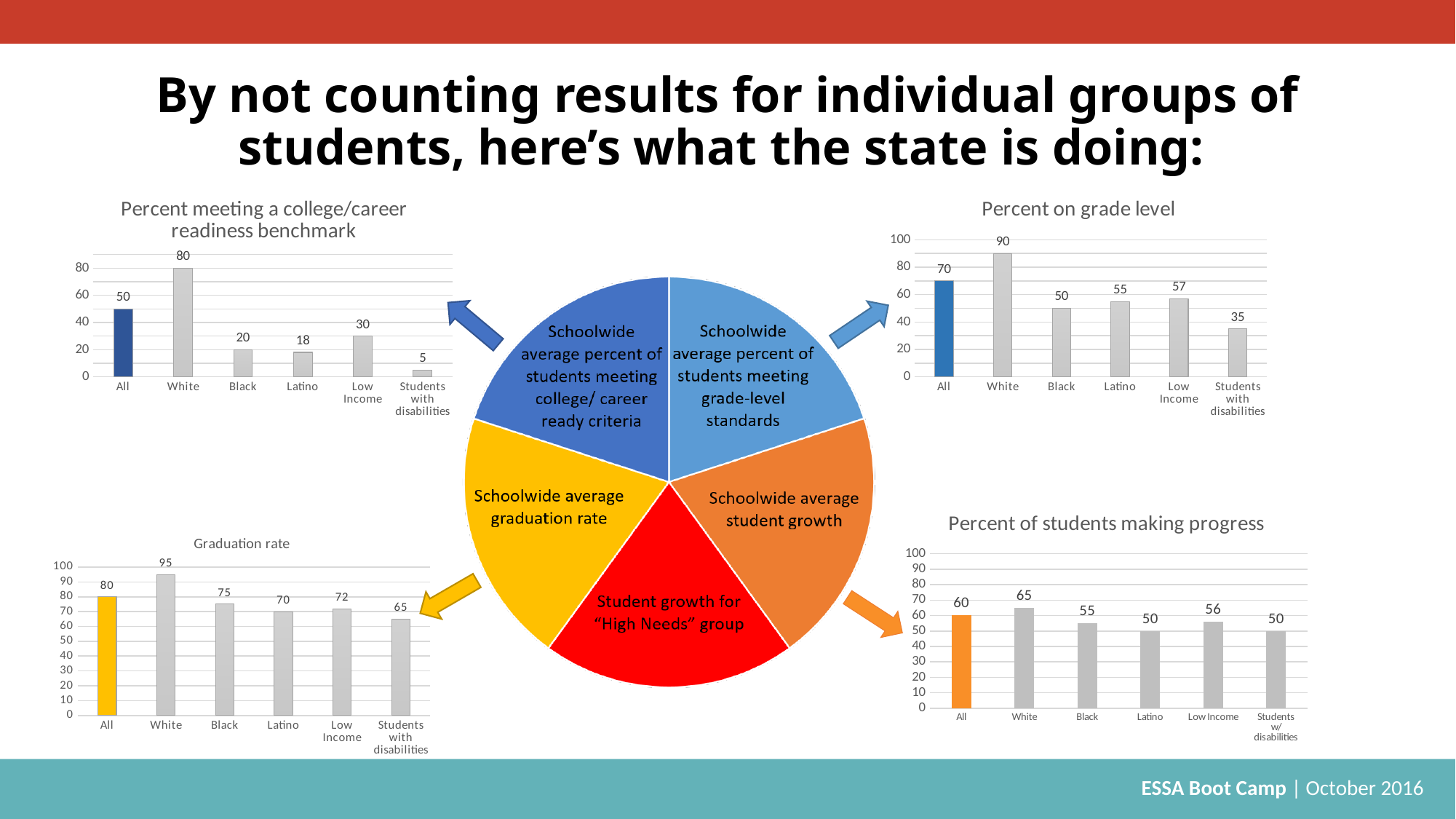
In the 'Percent meeting a college/career readiness benchmark' chart, which category has the lowest value? Students with disabilities In the 'Percent of students making progress' chart, what is the value for Black? 55 In the 'Graduation rate' chart, what is the difference between the All value and the White value? 15 What kind of chart is the 'Percent of students making progress' chart? Bar chart In the 'Percent on grade level' chart, what is the value for Low Income? 57 In the 'Percent meeting a college/career readiness benchmark' chart, what is the difference between the White value and the Latino value? 62 In the 'Graduation rate' chart, which is larger, the value for Latino or the value for Low Income? Low Income In the 'Graduation rate' chart, what is the value for Students with disabilities? 65 In the 'Percent on grade level' chart, which category has the highest value? White In the 'Percent of students making progress' chart, what colour is the bar for All? Orange In the 'Percent meeting a college/career readiness benchmark' chart, what is the value for Black? 20 In the 'Percent on grade level' chart, how many categories are shown on the x axis? 6